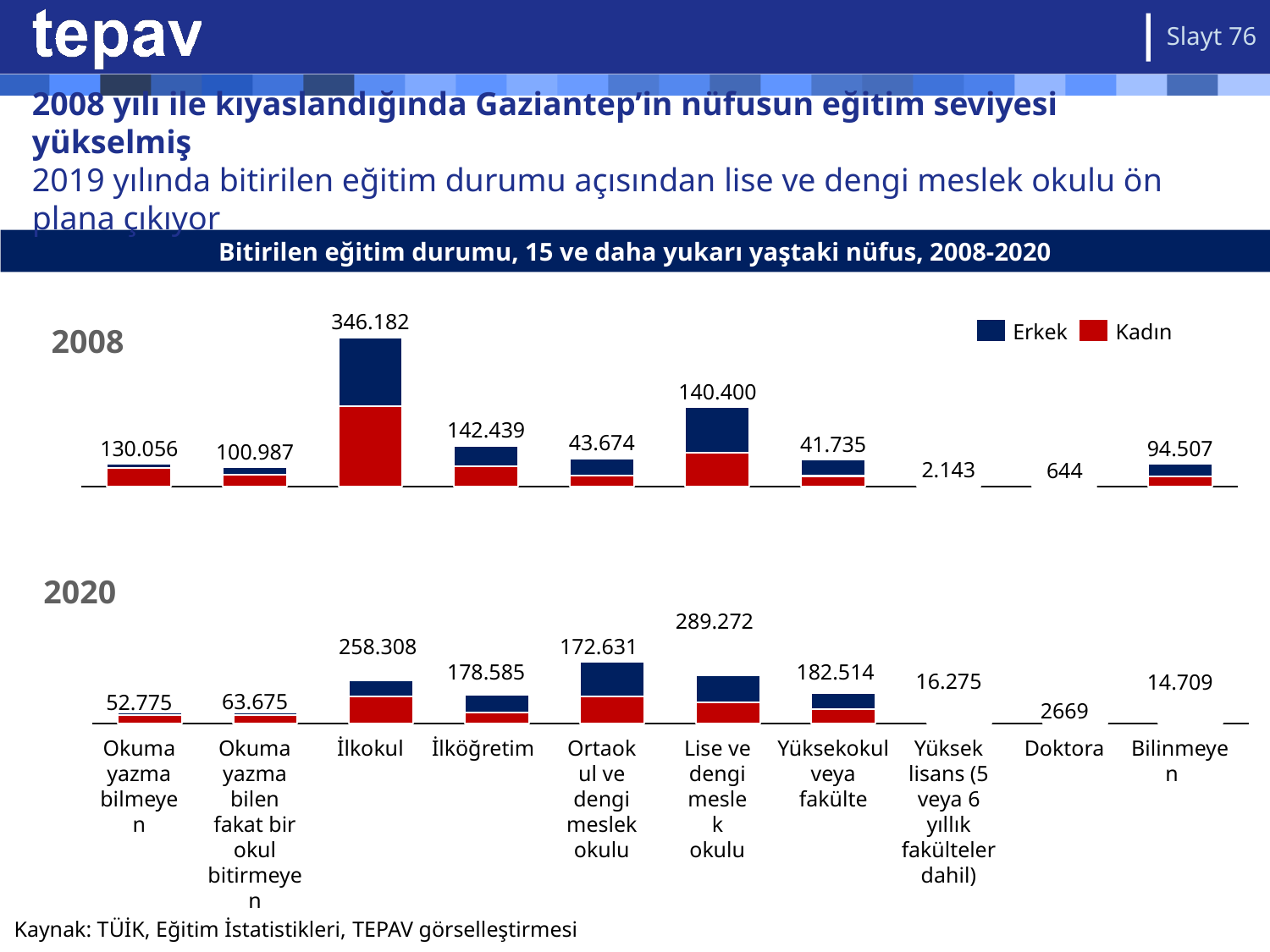
What is the difference between the İlkokul total in the 2008 chart and the İlkokul total in the 2020 chart? 87.874 In the 2020 chart, what is the value shown for Doktora? 2669 In the 2020 chart, which category has the lowest value? Doktora How many series does the legend list? 2 How many categories are shown along the x axis of the 2020 chart? 10 What kind of chart is used for the 2008 data? Stacked bar chart In the 2020 chart, which is larger: the total for Yüksekokul veya fakülte or the total for İlköğretim? Yüksekokul veya fakülte In the 2008 chart, which category has the lowest value? Doktora In the 2008 chart, what is the total value shown for İlkokul? 346.182 In the 2020 chart, what is the total value shown for Lise ve dengi meslek okulu? 289.272 In the 2020 chart, which category has the highest total? Lise ve dengi meslek okulu In the 2008 chart, which category has the highest total? İlkokul